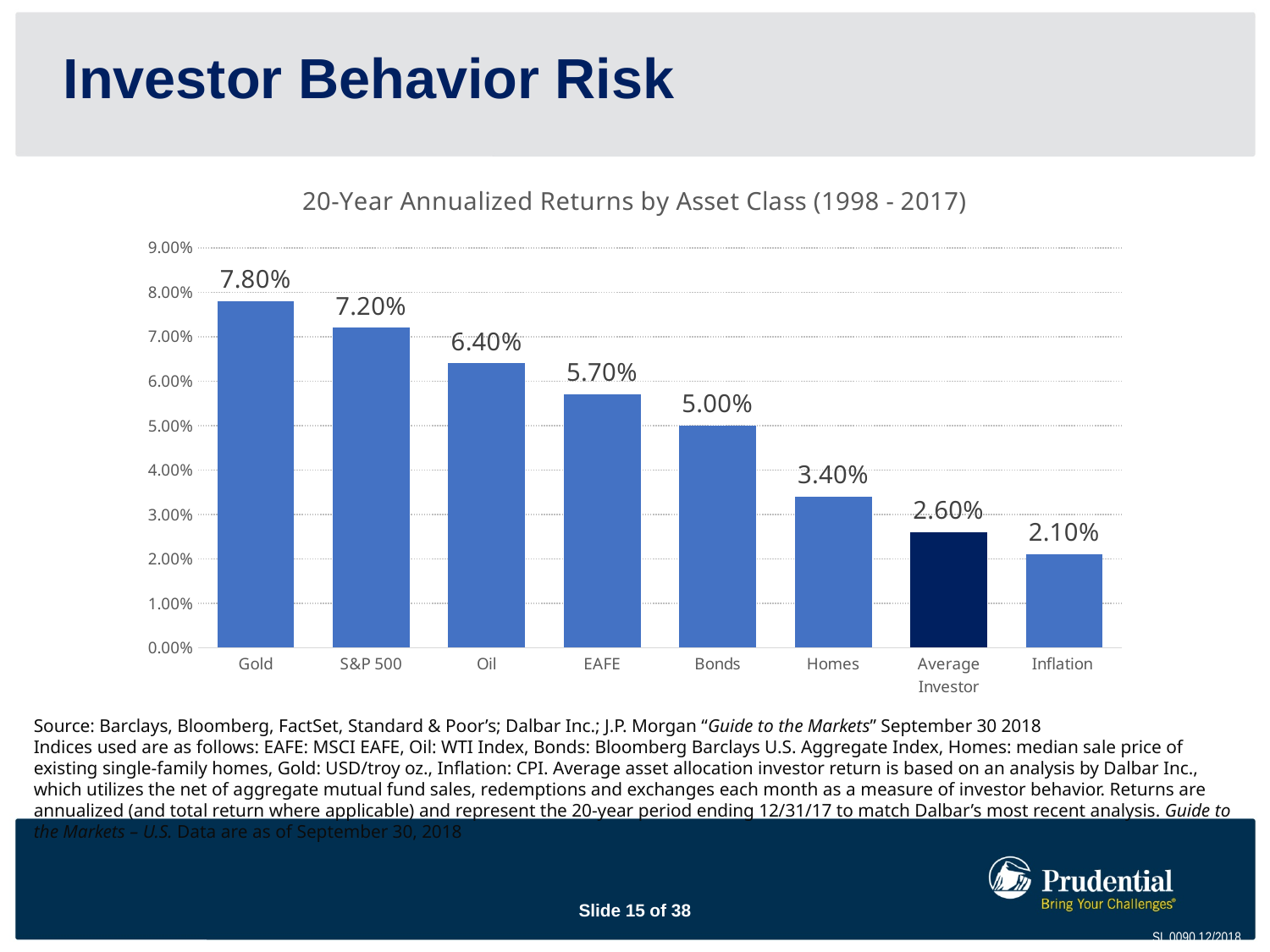
What is the value shown for the Average Investor? 2.60% Do the values rise or fall moving from left to right across the chart? fall Which is larger, the value for Oil or the value for EAFE? Oil Which category has the lowest value on the chart? Inflation What is the title of the chart? 20-Year Annualized Returns by Asset Class (1998 - 2017) What is the difference between the S&P 500 return and the Average Investor return? 4.60% What is the value shown for Bonds? 5.00% Which asset class has the highest annualized return on the chart? Gold Is the value for Homes greater or less than 4.00%? less What is the 20-year annualized return shown for Gold? 7.80% How many asset classes are shown on the chart? 8 What kind of chart is shown on the slide? bar chart